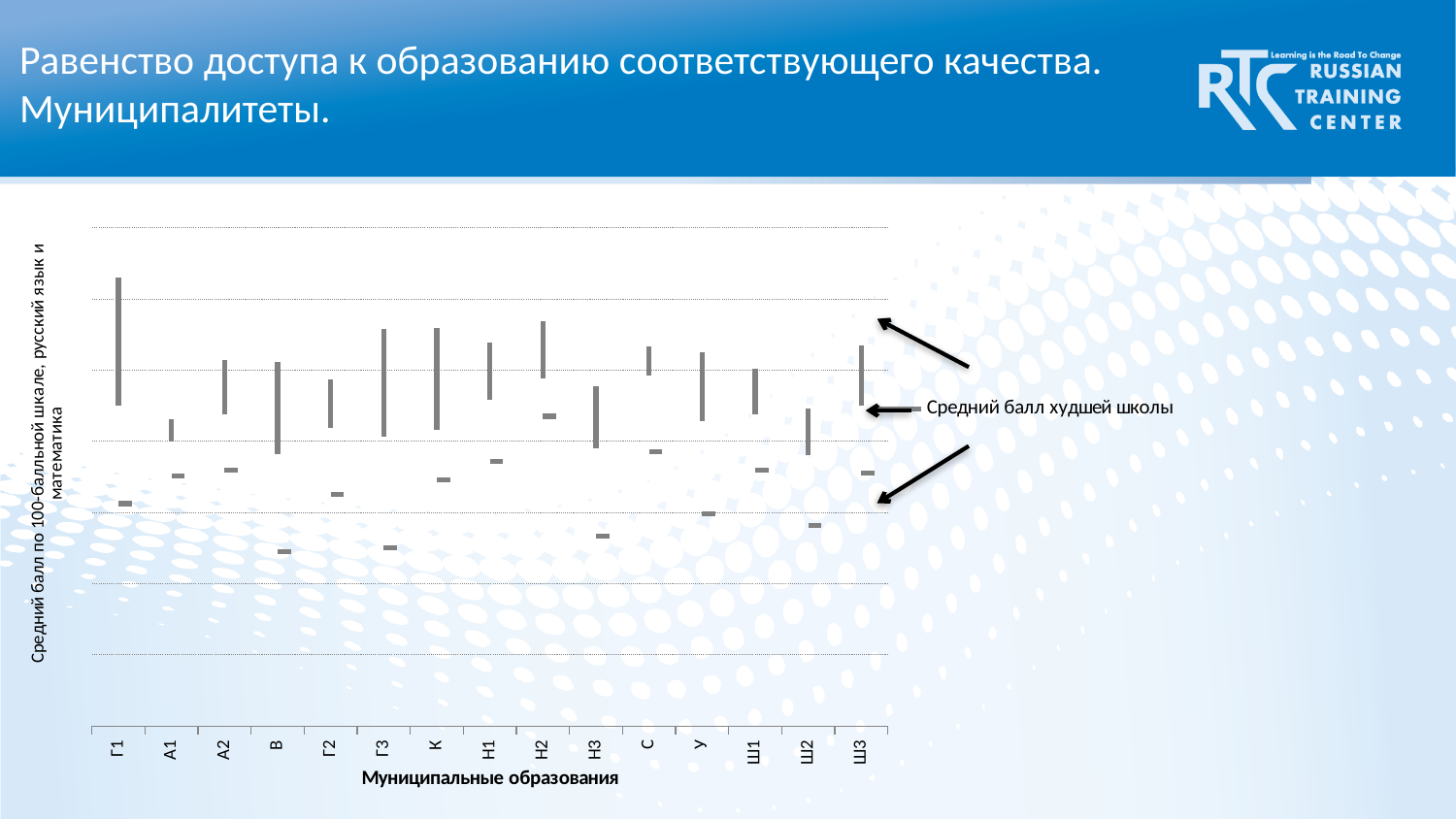
Which bar reaches higher on the chart, the one for Г1 or the one for А1? Г1 What is the label of the first category on the x axis? Г1 What does the annotation with the arrow on the chart say? Средний балл худшей школы What is the label of the last category on the x axis? Ш3 What is the title of the x axis of the chart? Муниципальные образования How many municipalities (categories) are shown along the x axis of the chart? 15 Which municipality's bar reaches the highest point on the chart? Г1 Which municipality has the longest (tallest) bar on the chart? Г1 Which bar reaches higher on the chart, the one for Н2 or the one for Ш2? Н2